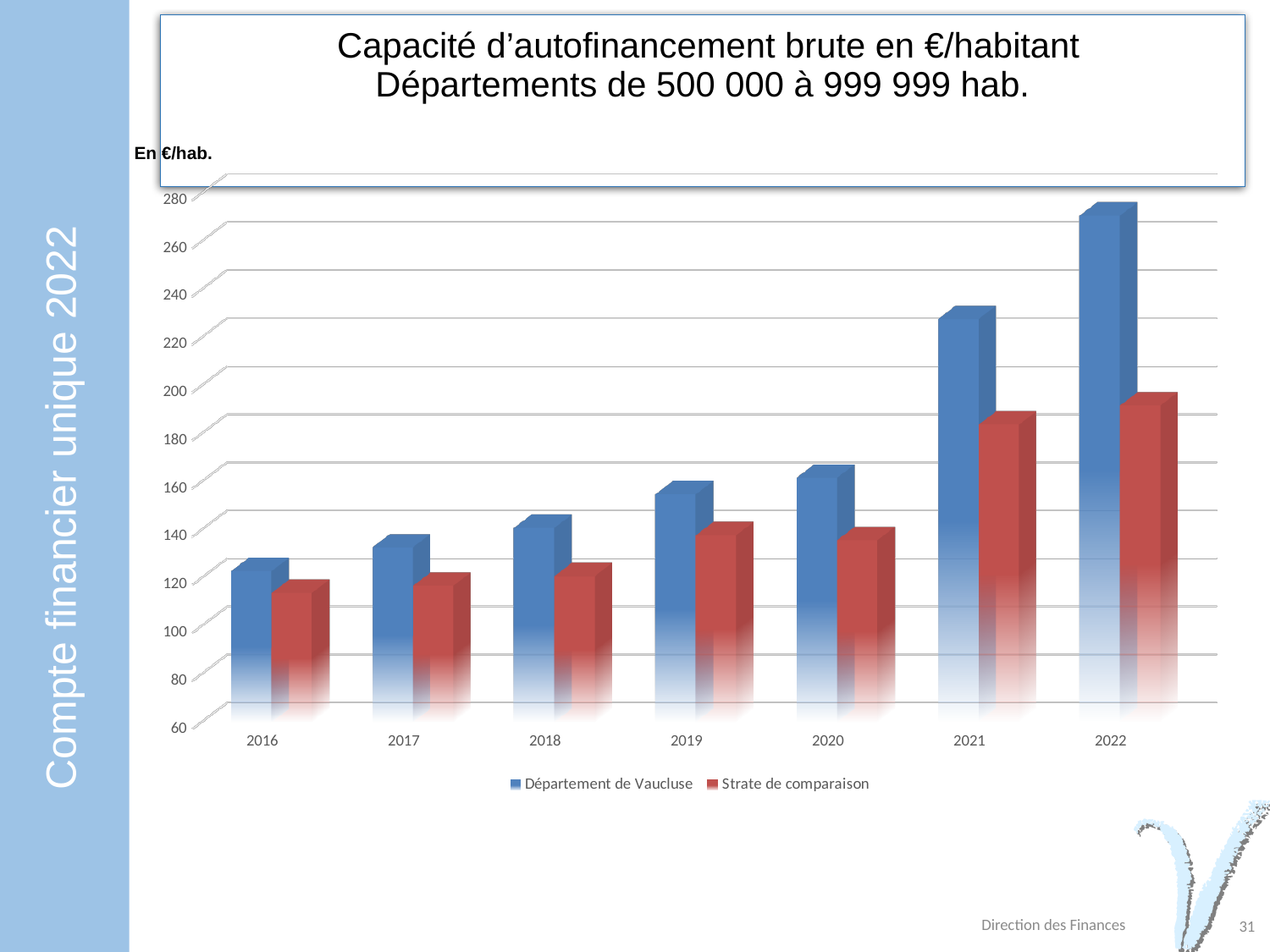
How many series does the legend list? 2 Is the value for Strate de comparaison in 2016 greater or less than 140? less How many years are shown on the x axis? 7 Is the value for Département de Vaucluse in 2022 greater or less than 260? greater What kind of chart is shown on the slide? bar chart What unit is indicated above the y axis of the chart? En €/hab. Which year has the highest value for Strate de comparaison? 2022 Which year has the highest value for Département de Vaucluse? 2022 Do the values for Département de Vaucluse rise or fall from 2016 to 2022? rise In 2022, which is larger: Département de Vaucluse or Strate de comparaison? Département de Vaucluse Which year has the lowest value for Département de Vaucluse? 2016 Is the value for Département de Vaucluse in 2021 greater or less than 220? greater